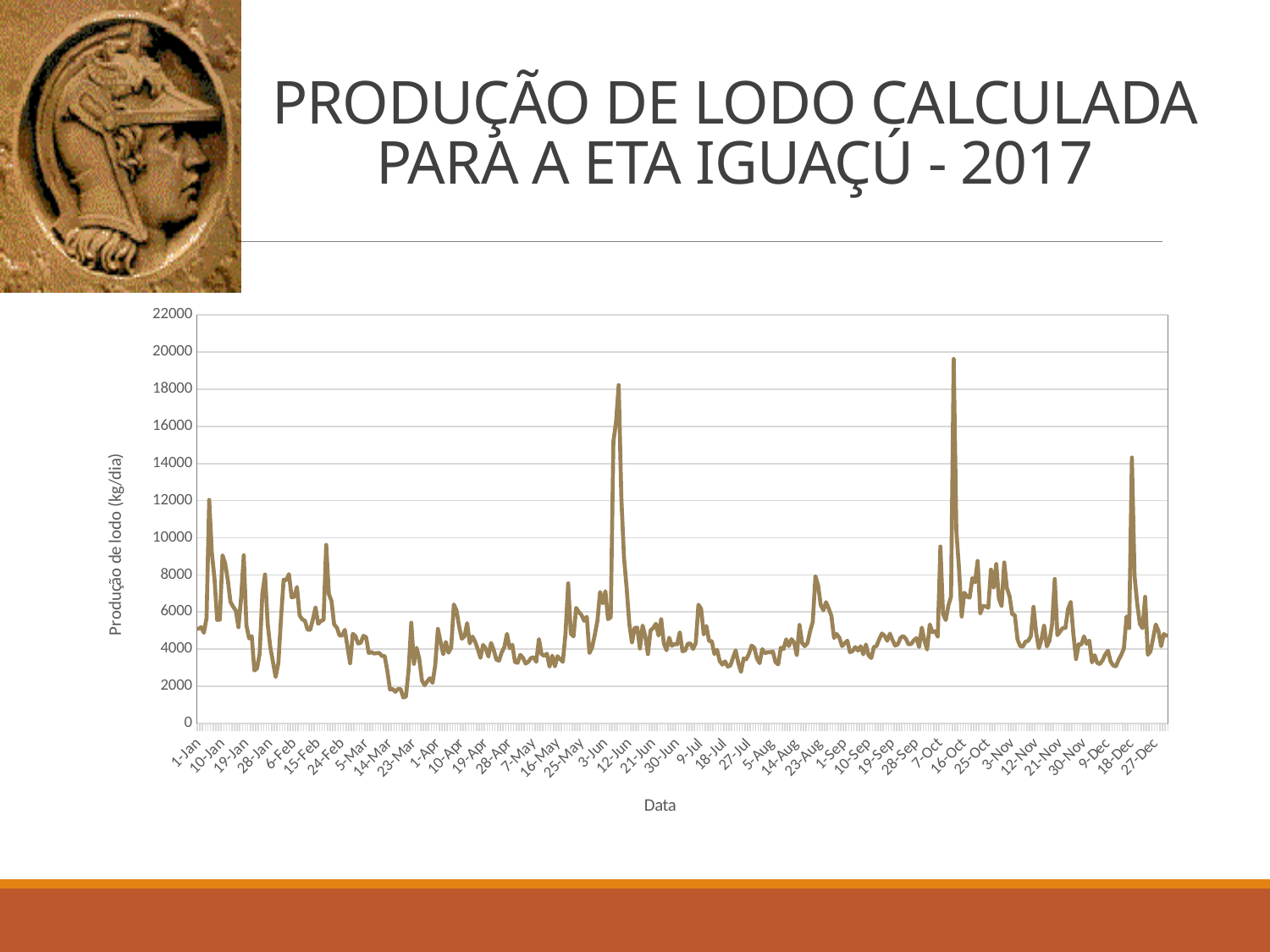
Is the lowest point of the line, near 23-Mar, greater or less than 2000? less Is the highest peak of the line, near 16-Oct, greater or less than 18000? greater What is the title of the y axis of the chart? Produção de lodo (kg/dia) What is the highest value shown on the y axis? 22000 Is the peak of the line near 12-Jun greater or less than 16000? greater What is the title of the x axis of the chart? Data What kind of chart is shown on the slide? line chart In which month does the line reach its lowest value? March Which is higher: the peak near 16-Oct or the peak near 12-Jun? the peak near 16-Oct In which month does the line reach its highest value? October